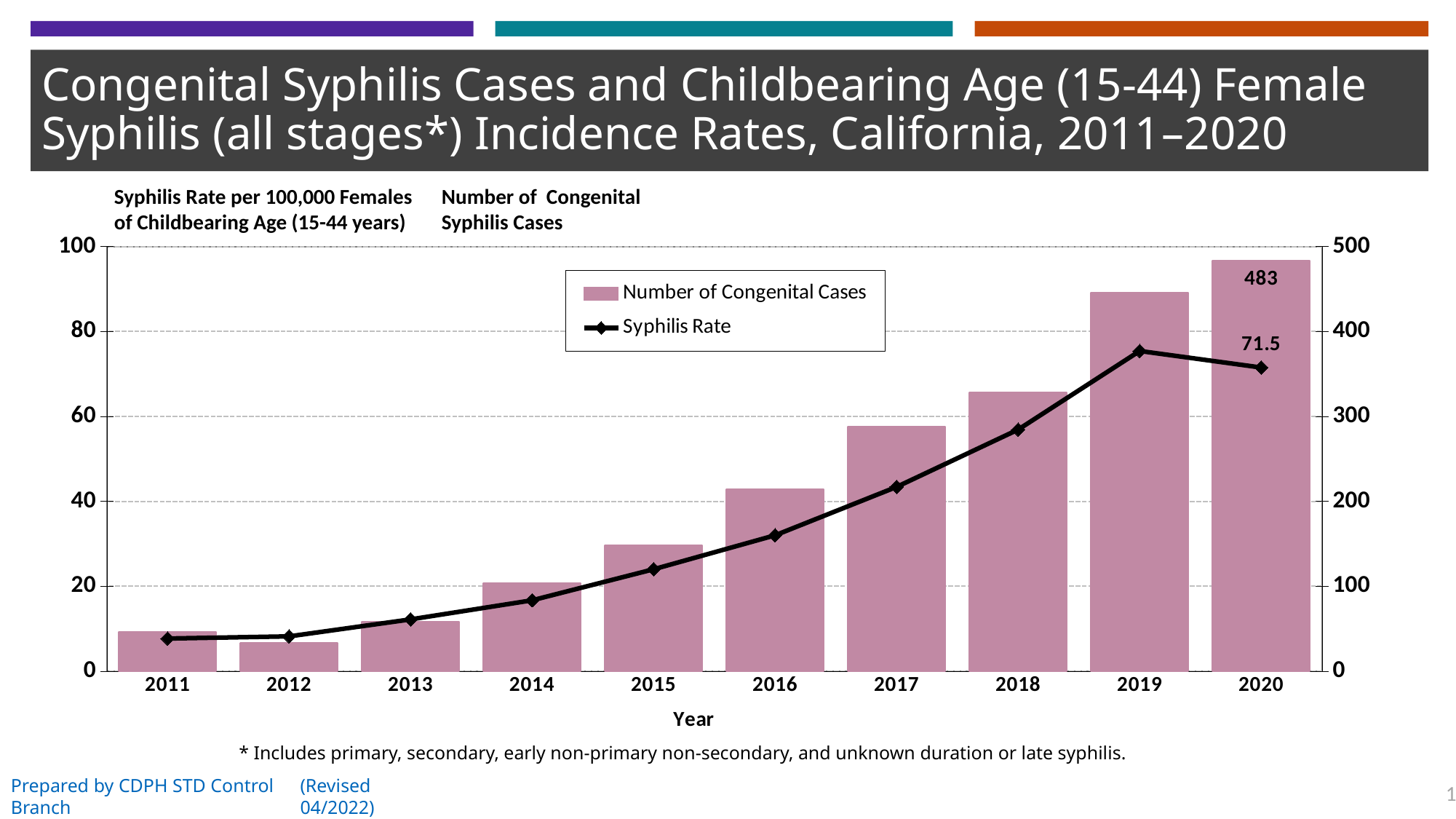
Which year has the highest syphilis rate? 2019 What kind of chart is shown on the slide? Combination bar and line chart Is the syphilis rate in 2015 greater or less than 40? less Is the number of congenital cases in 2019 greater or less than 400? greater Which year has the highest number of congenital syphilis cases? 2020 Which year has more congenital syphilis cases, 2017 or 2018? 2018 How many years are shown on the x axis? 10 Is the number of congenital cases in 2014 greater or less than 200? less What is the number of congenital syphilis cases in 2020? 483 What is the syphilis rate per 100,000 females of childbearing age in 2020? 71.5 How many series does the legend list? 2 Which year has the lowest number of congenital syphilis cases? 2012